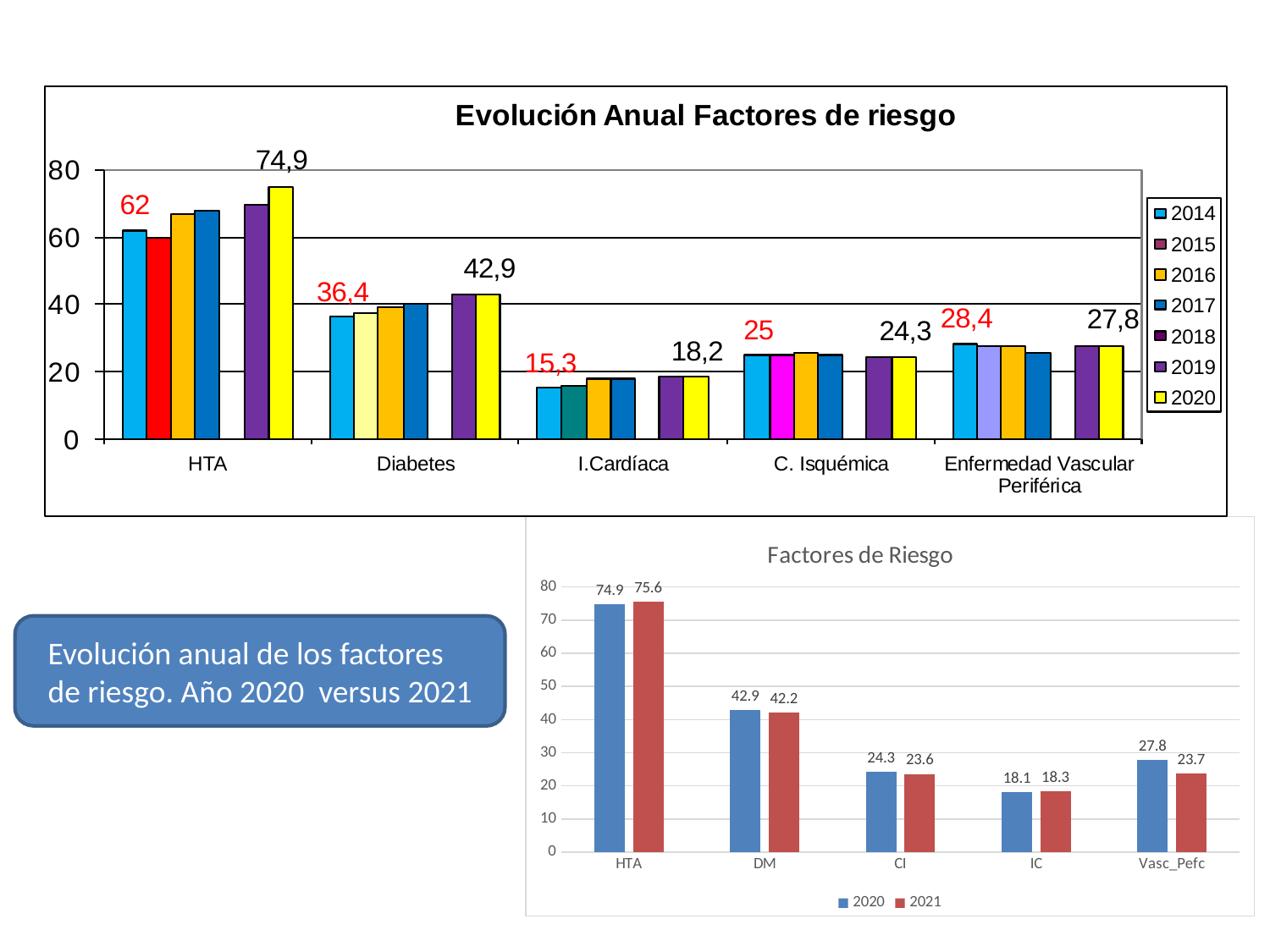
In the 'Evolución Anual Factores de riesgo' chart, what is the value for Diabetes in 2014? 36,4 In the 'Evolución Anual Factores de riesgo' chart, how many series does the legend list? 7 In the 'Evolución Anual Factores de riesgo' chart, is the 2017 value for Diabetes greater or less than 20? greater In the 'Factores de Riesgo' chart, which is larger for HTA: the 2020 value or the 2021 value? 2021 In the 'Evolución Anual Factores de riesgo' chart, which category has the highest values? HTA What kind of chart is the 'Factores de Riesgo' chart? Bar chart In the 'Factores de Riesgo' chart, which category has the lowest values? IC In the 'Evolución Anual Factores de riesgo' chart, how many categories are shown on the x axis? 5 In the 'Evolución Anual Factores de riesgo' chart, what is the value for HTA in 2020? 74,9 In the 'Evolución Anual Factores de riesgo' chart, what is the difference between the 2020 and 2014 values for HTA? 12,9 In the 'Factores de Riesgo' chart, what is the value for Vasc_Pefc in 2021? 23.7 In the 'Factores de Riesgo' chart, what is the difference between the 2020 and 2021 values for Vasc_Pefc? 4.1